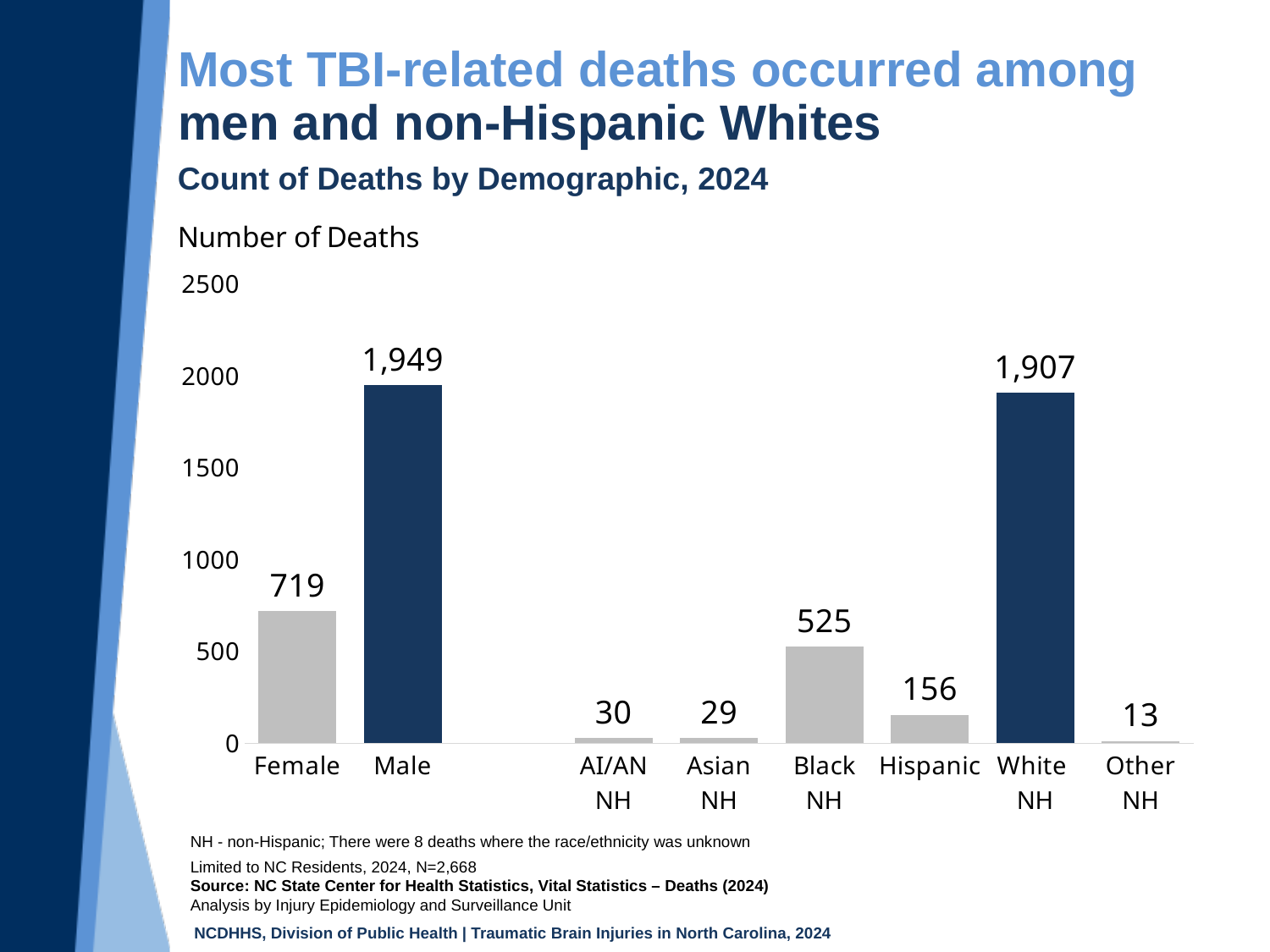
What kind of chart is shown on the slide? Bar chart What is the subtitle of the chart? Count of Deaths by Demographic, 2024 Which has more deaths, Female or Black NH? Female Which category has the highest number of deaths? Male What is the number of deaths for Black NH? 525 Which category has the lowest number of deaths? Other NH How many categories are shown on the x axis? 8 What is the difference in deaths between Male and Female? 1,230 What is the difference in deaths between White NH and Black NH? 1,382 What is the number of deaths for Hispanic? 156 Is the value for White NH greater or less than 1500? greater What is the number of deaths for Male? 1,949